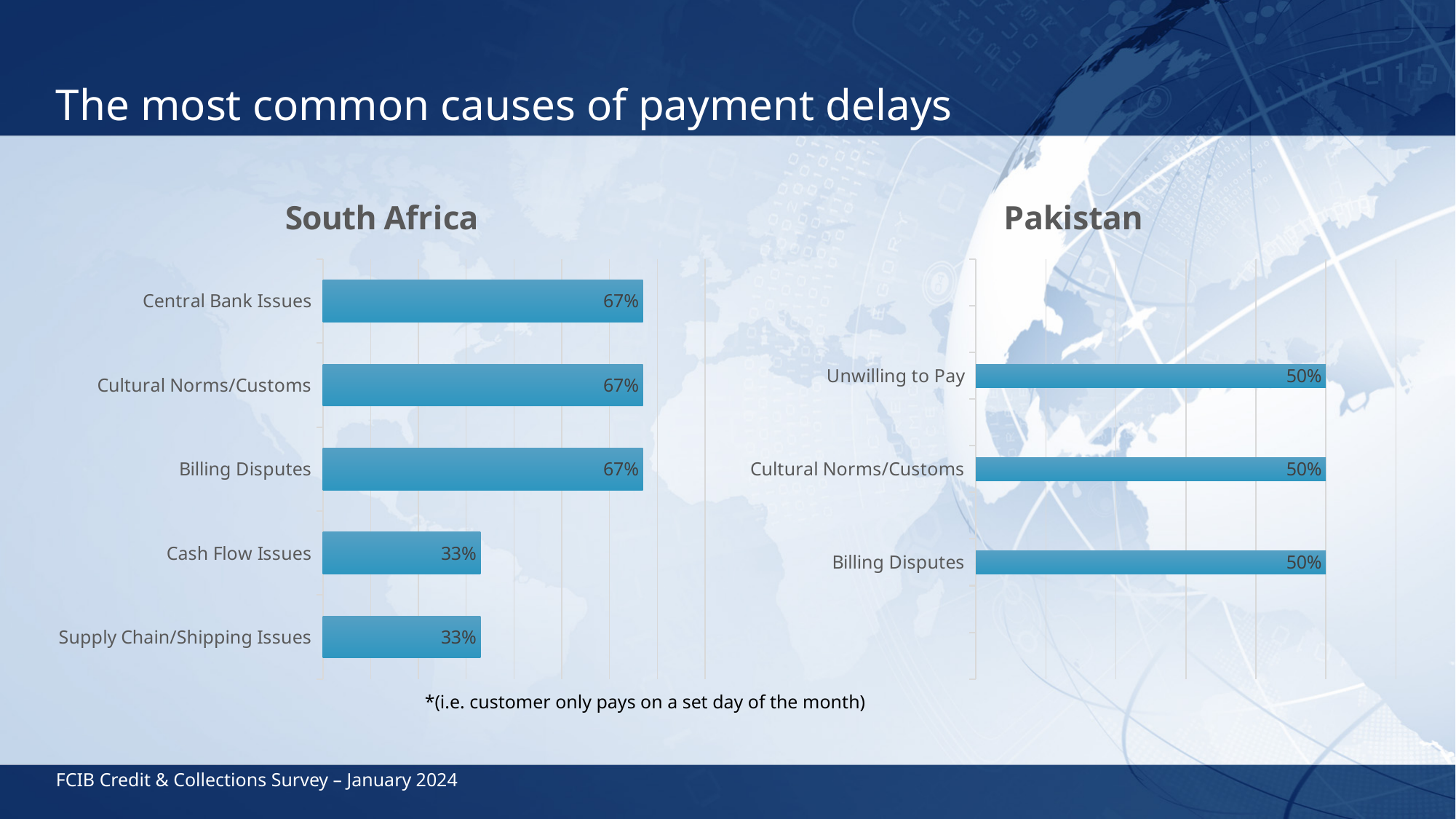
How many categories are shown in the Pakistan chart? 3 What is the title of the chart on the left side of the slide? South Africa In the South Africa chart, what is the value for Supply Chain/Shipping Issues? 33% In the South Africa chart, what is the difference between the values for Billing Disputes and Cash Flow Issues? 34% In the Pakistan chart, what is the value for Billing Disputes? 50% Which is larger, the value for Billing Disputes in the South Africa chart or the value for Billing Disputes in the Pakistan chart? South Africa In the South Africa chart, which is larger, the value for Cultural Norms/Customs or the value for Supply Chain/Shipping Issues? Cultural Norms/Customs How many categories are shown in the South Africa chart? 5 What kind of chart is the Pakistan chart? Bar chart In the South Africa chart, what is the value for Cash Flow Issues? 33% In the Pakistan chart, what is the value for Unwilling to Pay? 50% In the South Africa chart, what is the value for Central Bank Issues? 67%